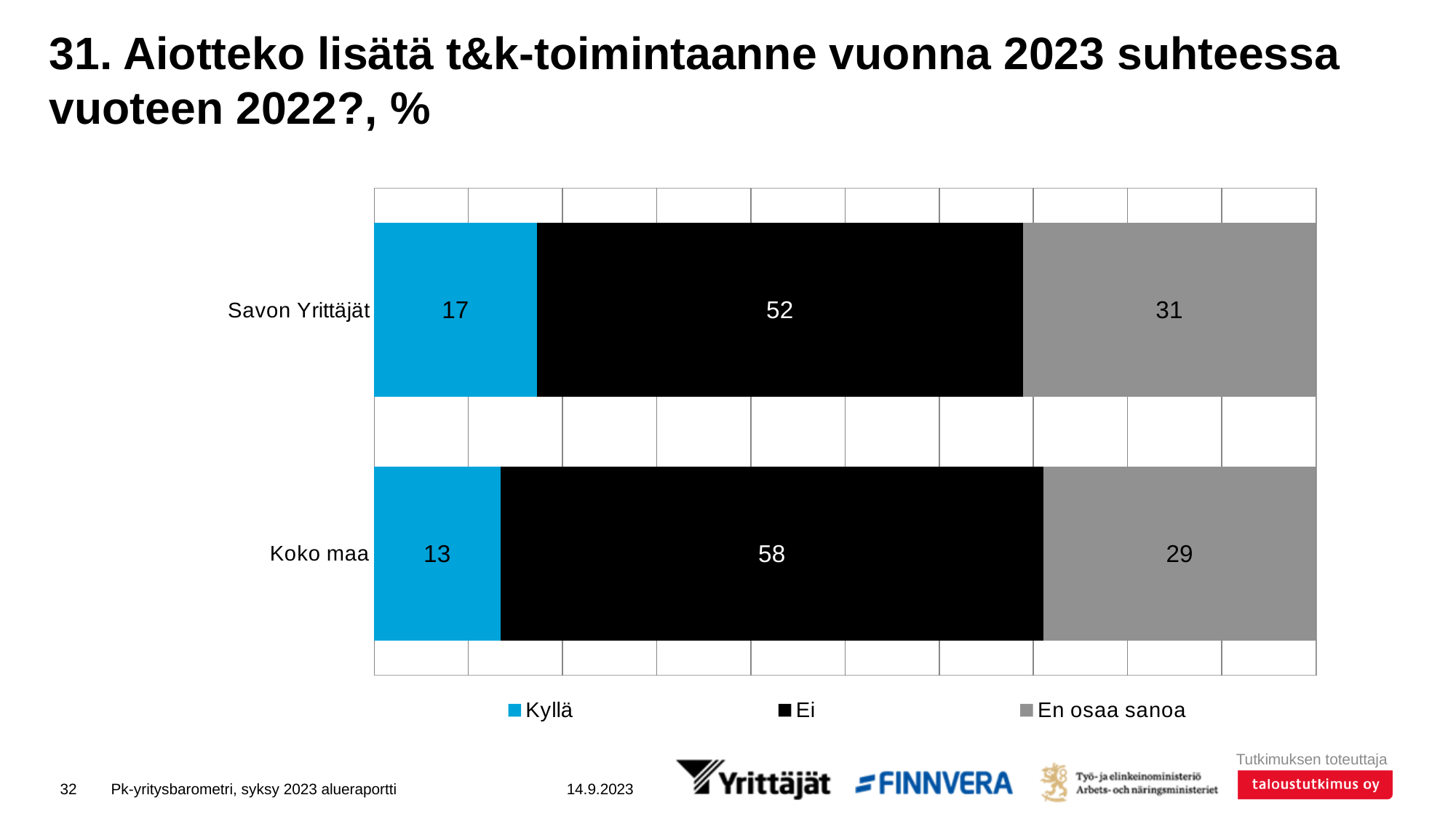
How many series does the legend list? 3 What is the value for Kyllä for Savon Yrittäjät? 17 Which series has the smallest value for Koko maa? Kyllä What is the total of the stacked bar for Savon Yrittäjät? 100 Which category has the higher Ei value, Savon Yrittäjät or Koko maa? Koko maa What is the difference between the Kyllä values for Savon Yrittäjät and Koko maa? 4 What is the difference between the Ei values for Koko maa and Savon Yrittäjät? 6 What is the value for Ei for Koko maa? 58 What kind of chart is shown on the slide? Stacked bar chart What is the value for En osaa sanoa for Savon Yrittäjät? 31 Which series has the largest value for Savon Yrittäjät? Ei What is the value for Kyllä for Koko maa? 13